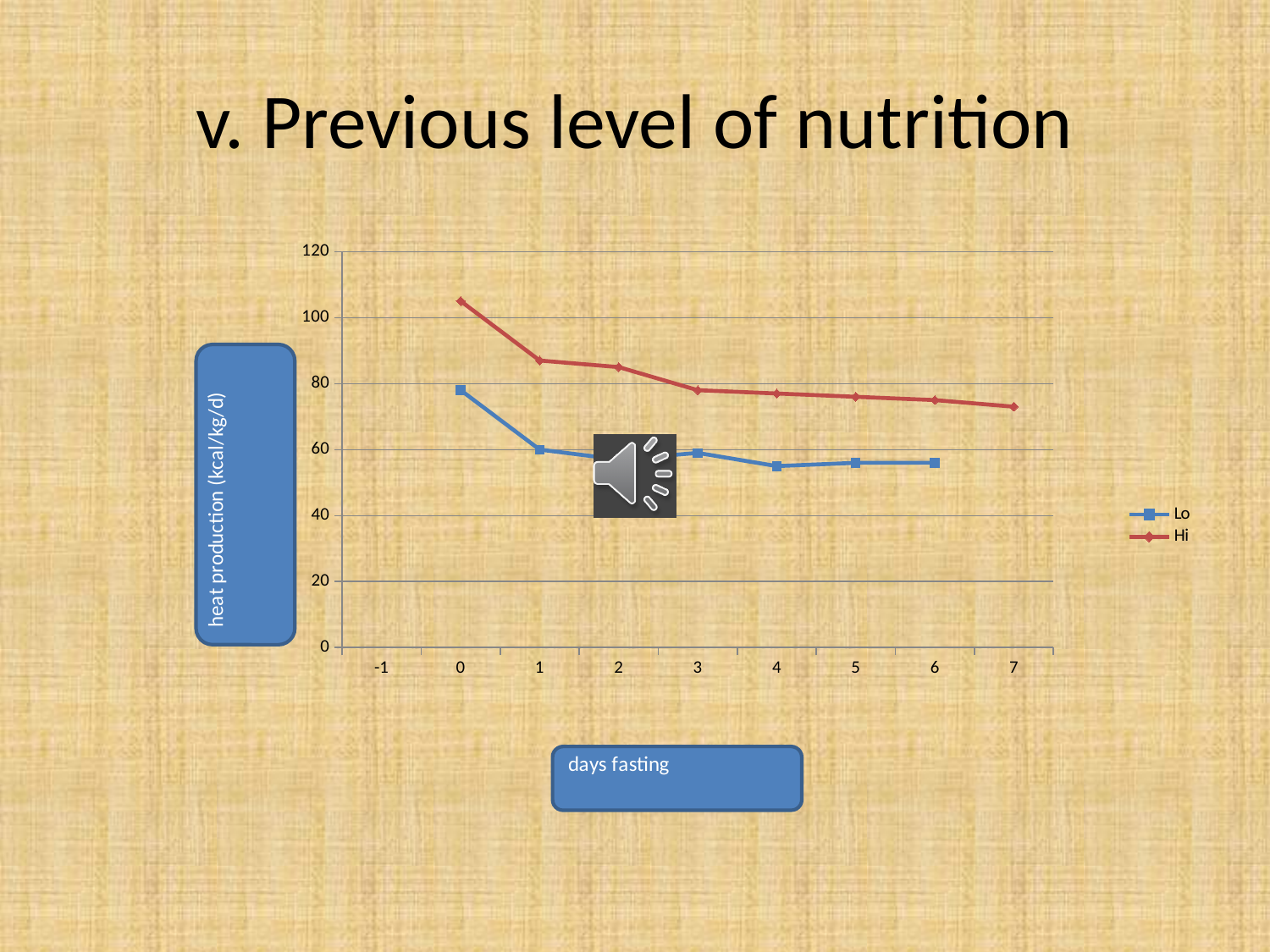
Is the value for the Hi series at day 0 greater or less than 100? greater Is the value for the Hi series at day 7 greater or less than 80? less How many series does the legend list? 2 What is the label of the vertical axis? heat production (kcal/kg/d) Is the value for the Lo series at day 1 greater or less than 40? greater How many data points are plotted for the Hi series? 8 Does the Hi series rise or fall as days fasting increase? fall Which series is plotted in red? Hi At day 0, which series has the higher heat production, Lo or Hi? Hi What kind of chart is shown on the slide? line chart